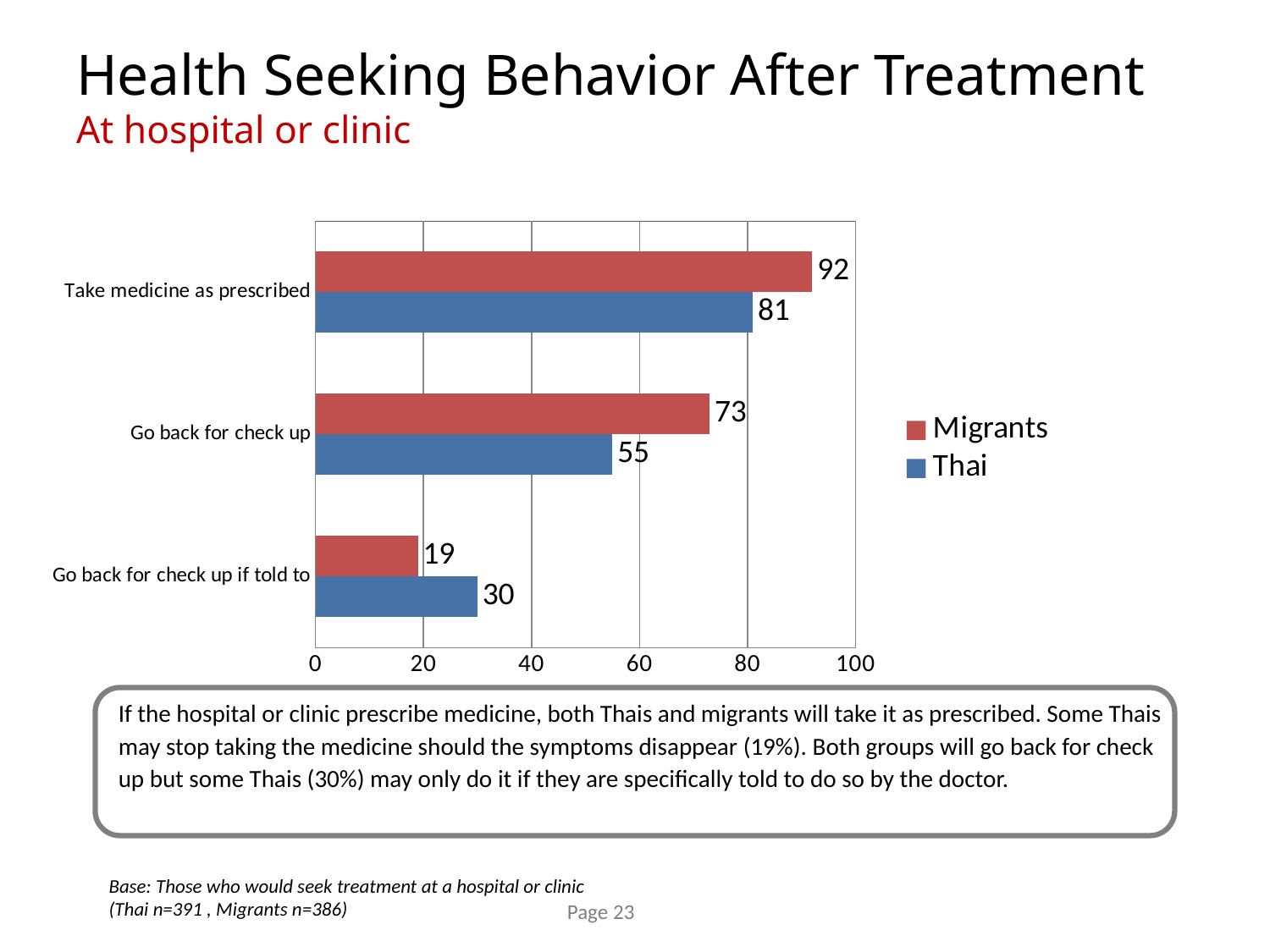
What is the value for Thai for 'Go back for check up if told to'? 30 What is the value for Migrants for 'Take medicine as prescribed'? 92 What is the value for Thai for 'Go back for check up'? 55 What is the value for Migrants for 'Go back for check up if told to'? 19 Which category has the highest value for Thai? Take medicine as prescribed Which colour represents Migrants in the chart? Red What kind of chart is shown on the slide? Bar chart Which category has the lowest value for Migrants? Go back for check up if told to How many categories are shown on the chart? 3 What is the difference between the Migrants and Thai values for 'Go back for check up'? 18 How many series does the legend list? 2 For 'Go back for check up if told to', which group has the larger value, Migrants or Thai? Thai